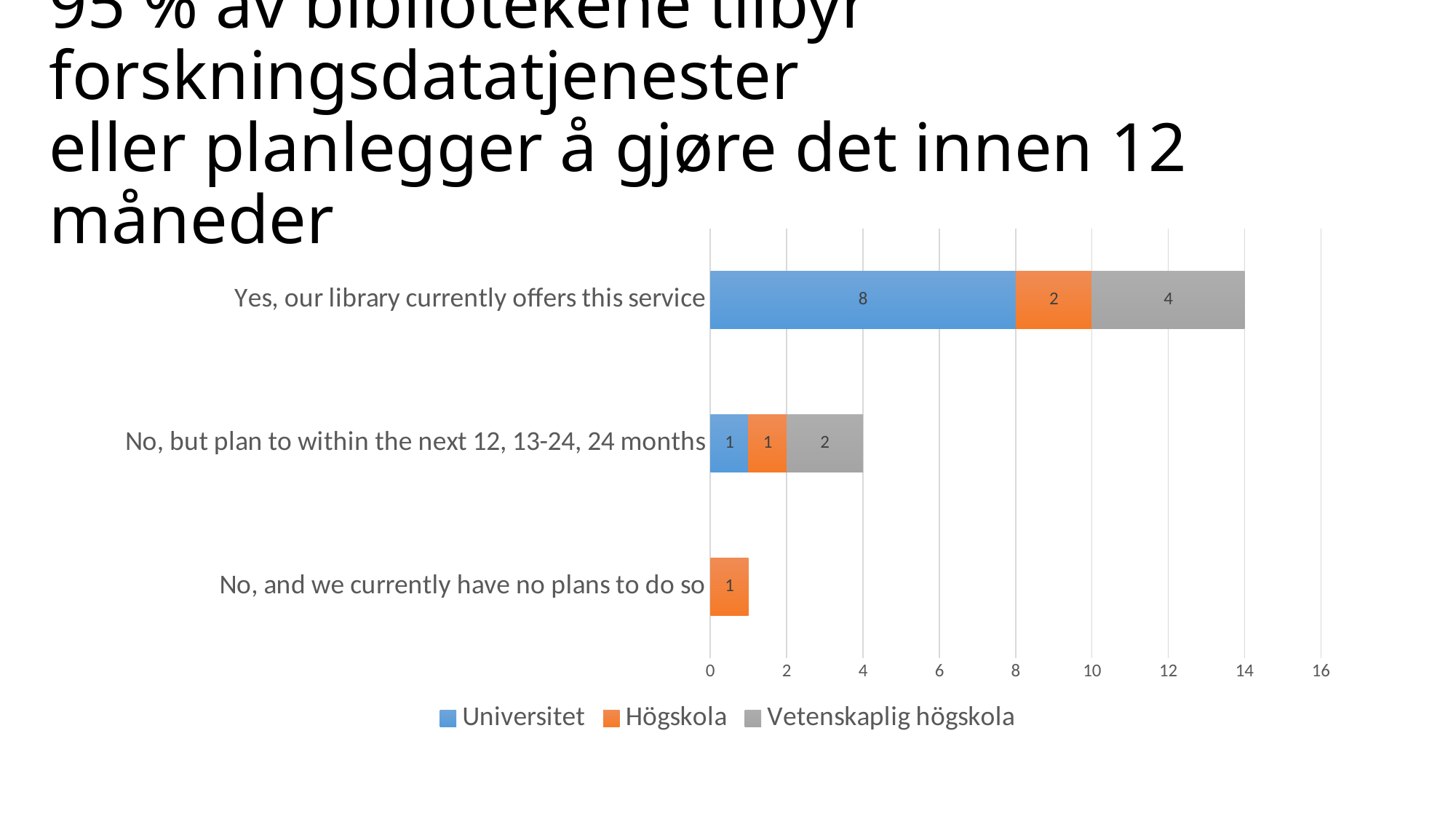
What is the Högskola value for "Yes, our library currently offers this service"? 2 What is the Högskola value for "No, and we currently have no plans to do so"? 1 How many series does the legend list? 3 Which category has the lowest total across all series? No, and we currently have no plans to do so What kind of chart is shown on the slide? Stacked bar chart What is the Universitet value for "Yes, our library currently offers this service"? 8 Which is larger for "Yes, our library currently offers this service": the Universitet value or the Högskola value? Universitet Which category has the highest total across all series? Yes, our library currently offers this service What is the Vetenskaplig högskola value for "No, but plan to within the next 12, 13-24, 24 months"? 2 What is the difference between the Universitet and Vetenskaplig högskola values for "Yes, our library currently offers this service"? 4 What is the total of the stacked bar for "Yes, our library currently offers this service"? 14 What is the total of the stacked bar for "No, but plan to within the next 12, 13-24, 24 months"? 4